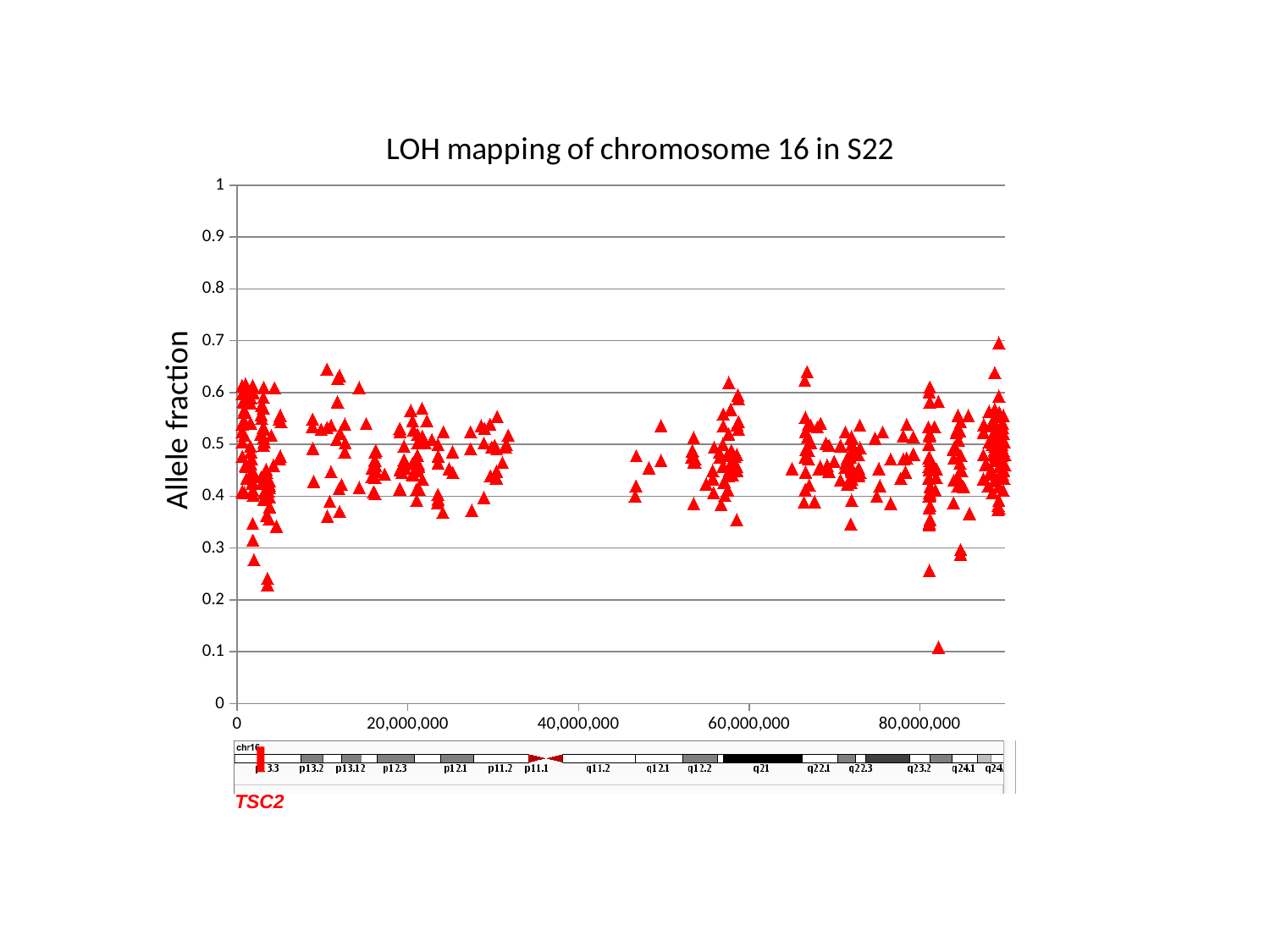
What is the maximum value shown on the vertical axis? 1 Is the highest plotted point located at a horizontal position greater or less than 80,000,000? greater Is the lowest plotted allele fraction value greater or less than 0.2? less What kind of chart is shown on the slide? scatter plot What is the title of the chart? LOH mapping of chromosome 16 in S22 What is the interval between consecutive tick labels on the vertical axis? 0.1 Is the highest plotted allele fraction value greater or less than 0.6? greater What is the label on the vertical axis of the chart? Allele fraction What is the largest tick label shown on the horizontal axis? 80,000,000